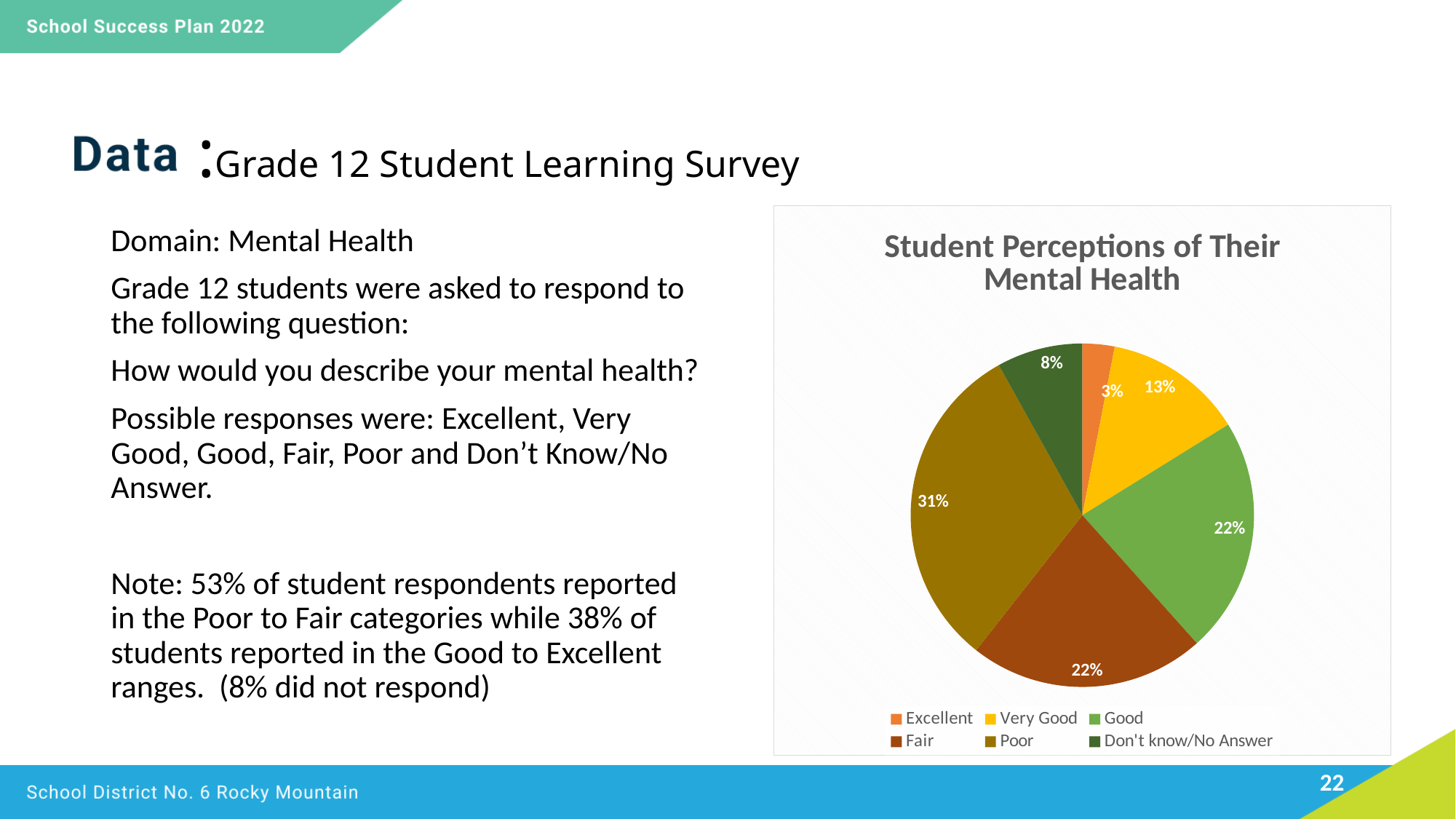
What is the combined percentage of the Good and Fair slices? 44% What type of chart is shown on the slide? pie chart What percentage of students described their mental health as Very Good? 13% What is the title of the chart? Student Perceptions of Their Mental Health How many response categories are shown in the pie chart? 6 Which response category has the smallest slice of the pie? Excellent What percentage of students described their mental health as Excellent? 3% What percentage of students described their mental health as Poor? 31% What share of the pie is Don't know/No Answer? 8% Which slice is larger, Poor or Good? Poor Which response category has the largest slice of the pie? Poor What is the difference in percentage points between the Poor and Very Good slices? 18